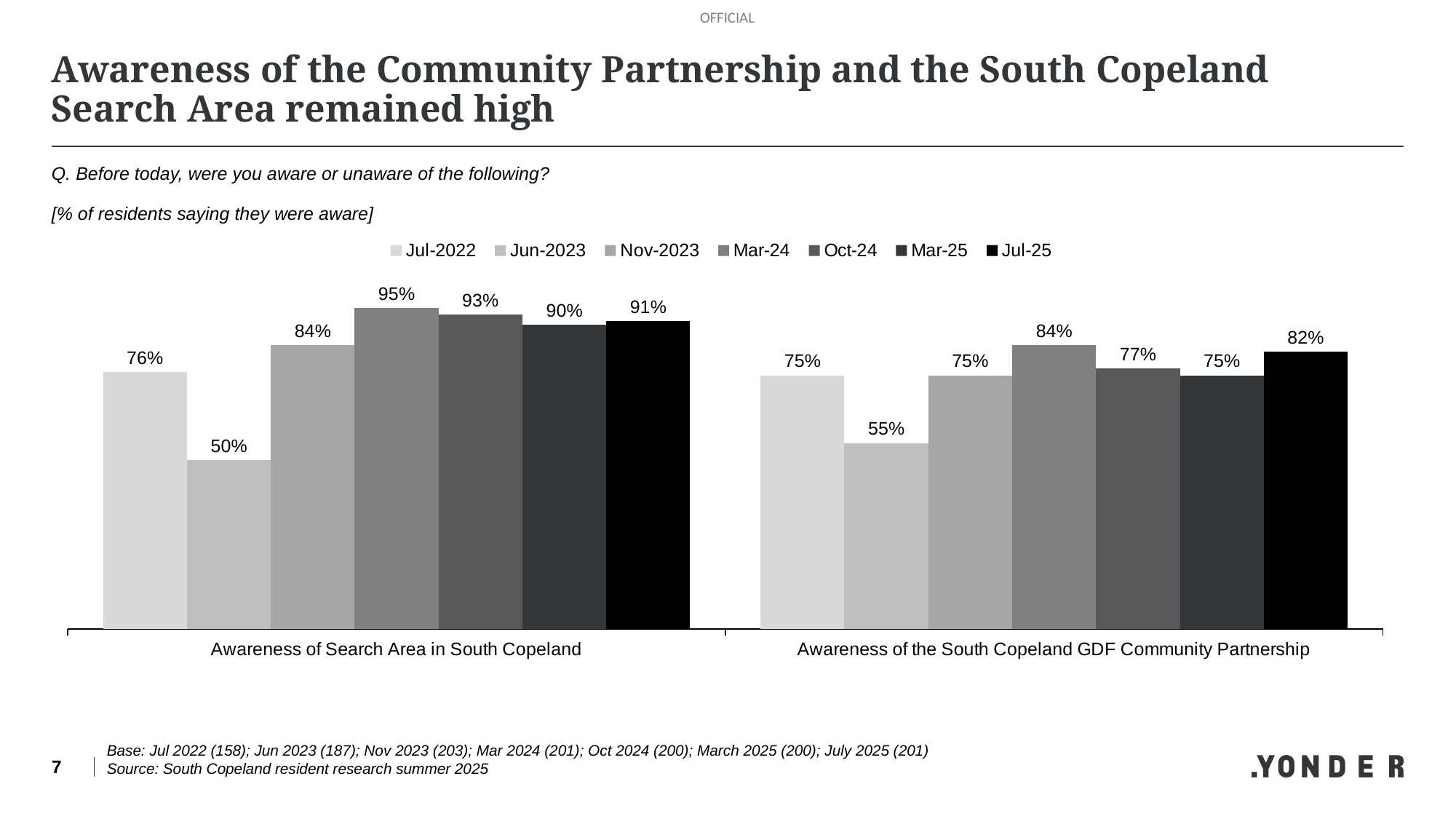
Which survey wave is shown in black in the legend? Jul-25 What is the difference between Mar-24 and Jun-2023 awareness of the Search Area in South Copeland? 45 percentage points How many survey waves does the legend list? 7 What kind of chart is shown on the slide? Bar chart Which is larger: Jul-25 awareness of the Search Area in South Copeland or Jul-25 awareness of the South Copeland GDF Community Partnership? Awareness of Search Area in South Copeland What was awareness of the South Copeland GDF Community Partnership in Oct-24? 77% Did awareness of the South Copeland GDF Community Partnership rise or fall between Mar-25 and Jul-25? Rise Which survey wave had the highest awareness of the Search Area in South Copeland? Mar-24 Which survey wave had the lowest awareness of the South Copeland GDF Community Partnership? Jun-2023 What percentage of residents were aware of the Search Area in South Copeland in Jul-25? 91% How many categories are shown on the x axis? 2 What was awareness of the South Copeland GDF Community Partnership in Jun-2023? 55%